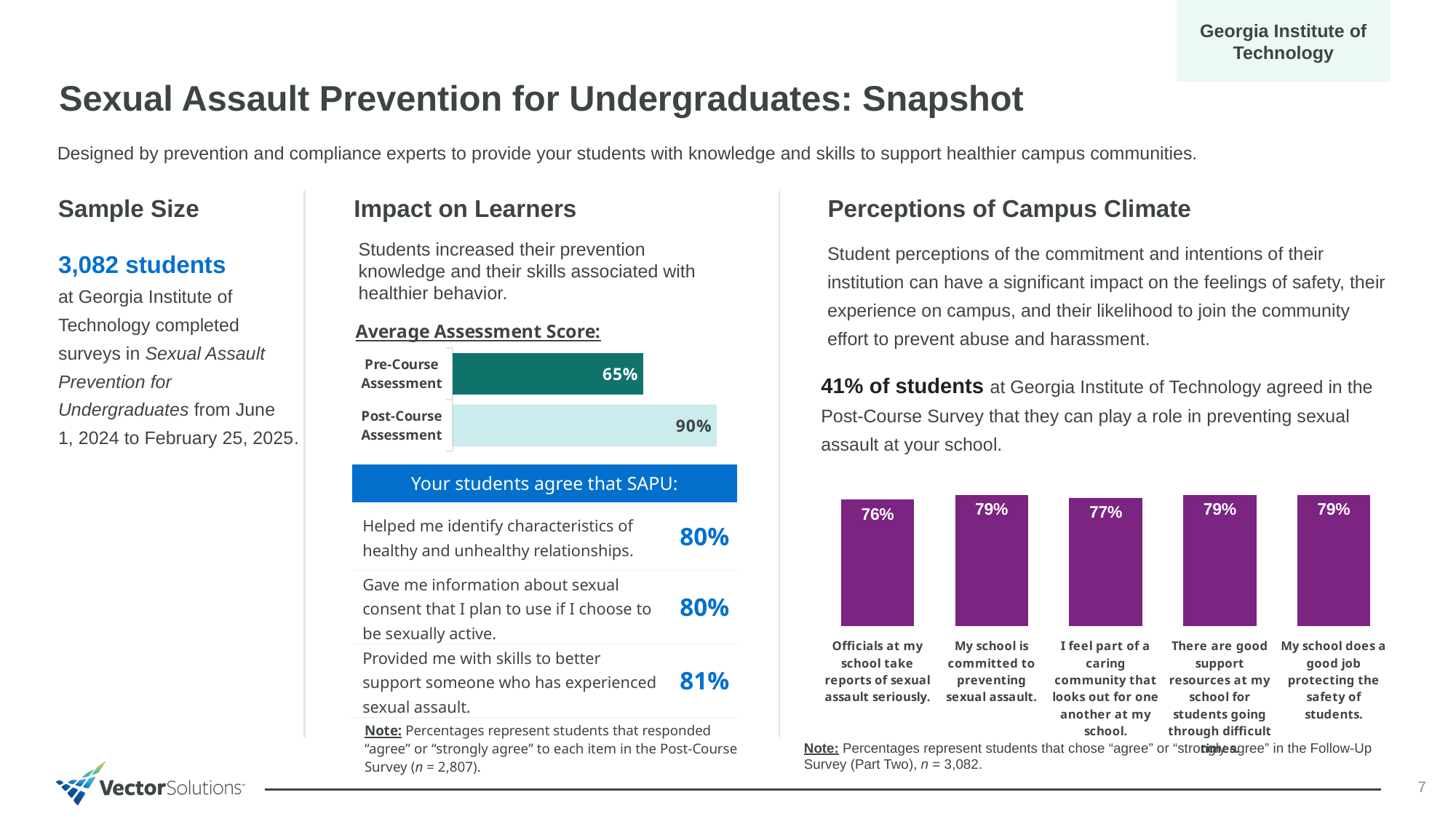
In the Perceptions of Campus Climate chart, what is the difference between 'My school is committed to preventing sexual assault' and 'Officials at my school take reports of sexual assault seriously'? 3% In the Perceptions of Campus Climate chart, which item has the lowest percentage? Officials at my school take reports of sexual assault seriously. What kind of chart is the Average Assessment Score chart? Bar chart How many bars are in the Perceptions of Campus Climate chart? 5 What colour are the bars in the Perceptions of Campus Climate chart? Purple In the Average Assessment Score chart, what is the value for the Pre-Course Assessment? 65% In the Average Assessment Score chart, which assessment has the higher score, Pre-Course or Post-Course? Post-Course Assessment In the Average Assessment Score chart, what is the value for the Post-Course Assessment? 90% In the Perceptions of Campus Climate chart, what percentage of students agreed that 'I feel part of a caring community that looks out for one another at my school'? 77% In the Average Assessment Score chart, what is the difference between the Post-Course and Pre-Course Assessment scores? 25% In the Perceptions of Campus Climate chart, what percentage of students agreed that officials at my school take reports of sexual assault seriously? 76% In the Perceptions of Campus Climate chart, what percentage of students agreed that my school does a good job protecting the safety of students? 79%